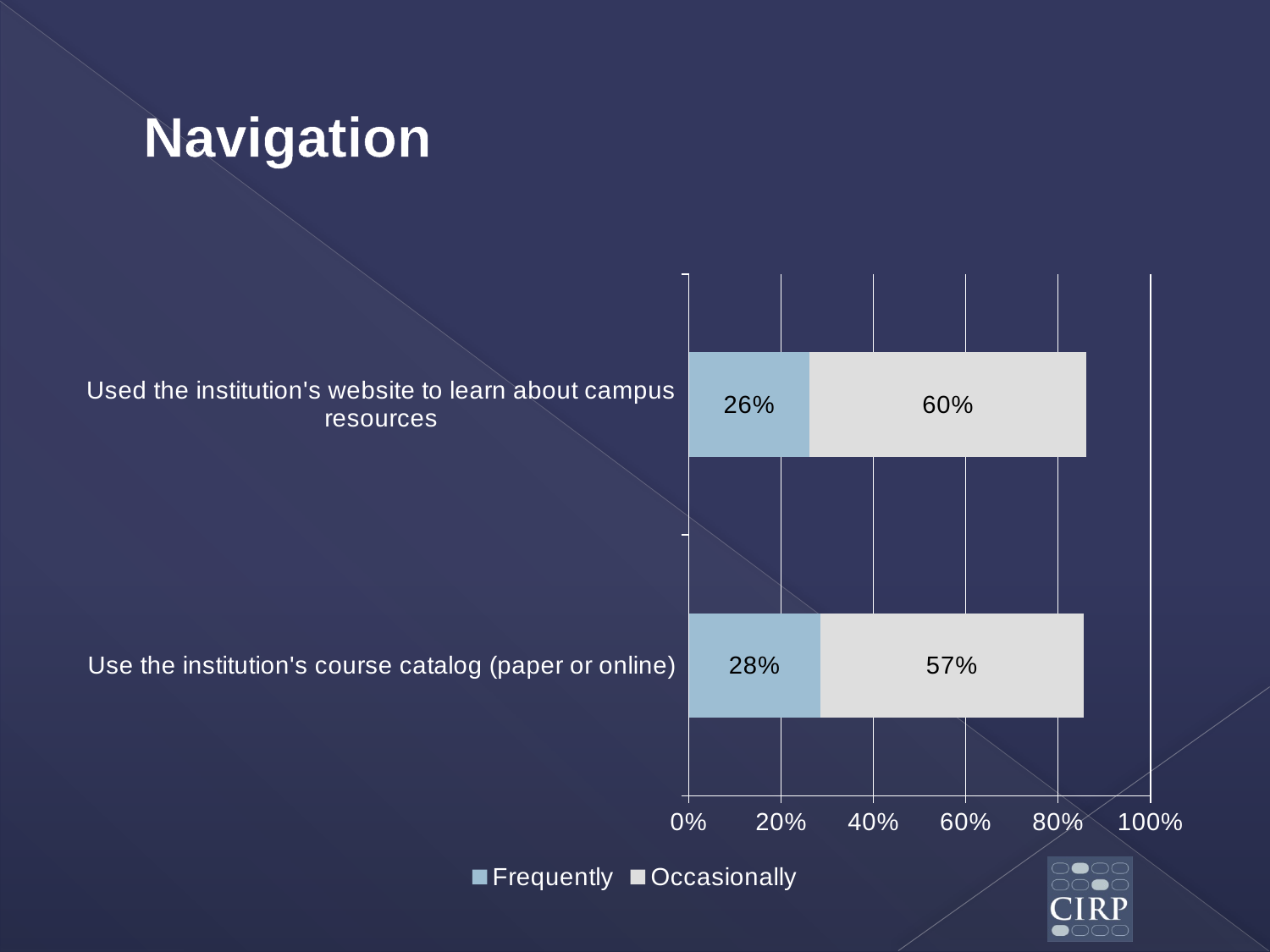
What is the total of the stacked bar for "Used the institution's website to learn about campus resources"? 86% Which category has the higher Occasionally value? Used the institution's website to learn about campus resources What is the Occasionally value for "Used the institution's website to learn about campus resources"? 60% Which category has the lower Frequently value? Used the institution's website to learn about campus resources What is the total of the stacked bar for "Use the institution's course catalog (paper or online)"? 85% What is the Occasionally value for "Use the institution's course catalog (paper or online)"? 57% How many series does the legend list? 2 What is the difference between the Occasionally values for the two categories? 3% What is the Frequently value for "Used the institution's website to learn about campus resources"? 26% What is the Frequently value for "Use the institution's course catalog (paper or online)"? 28% What kind of chart is shown on the slide? Stacked bar chart How many categories are shown in the chart? 2